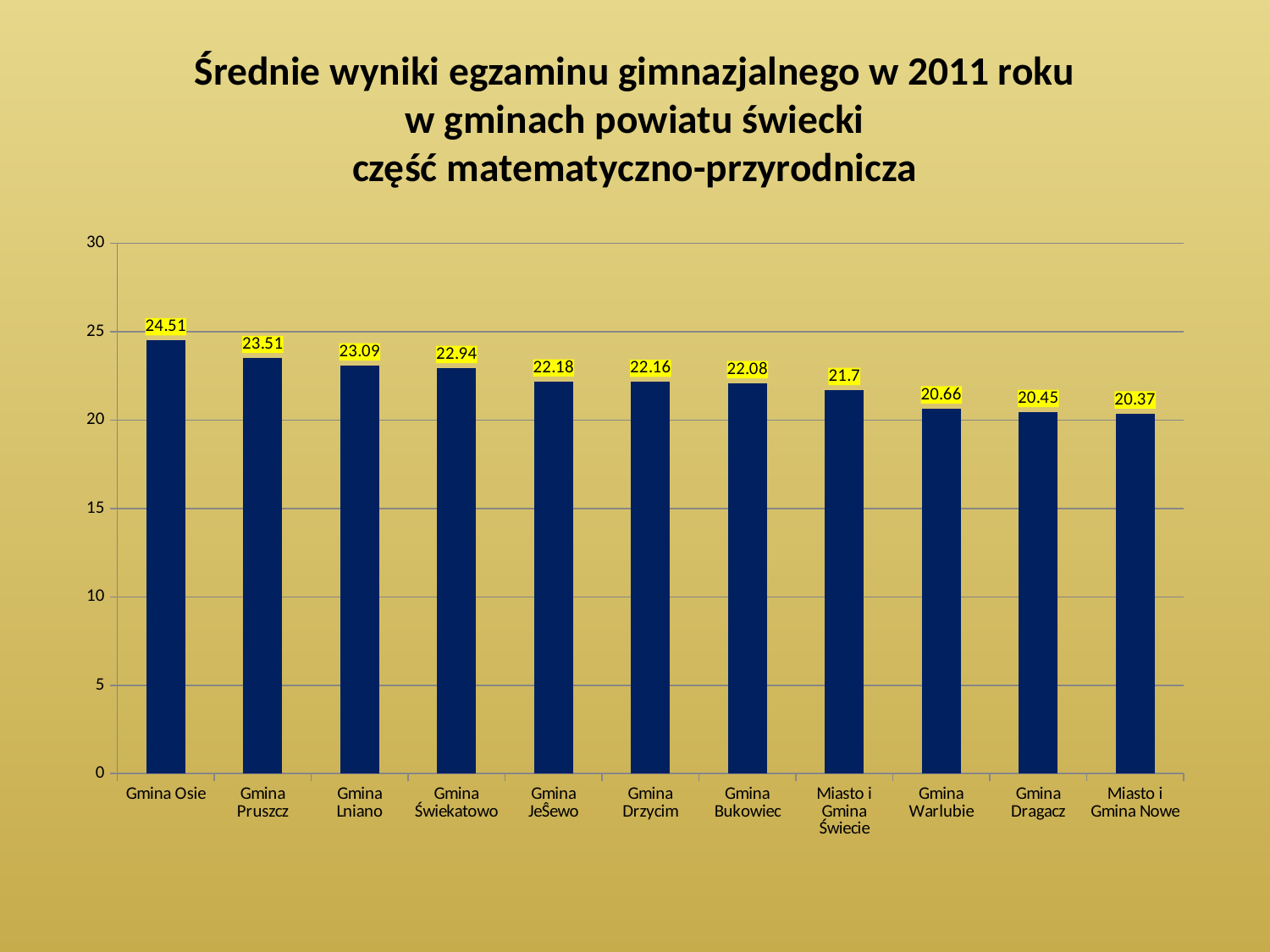
What is the value for Gmina Osie? 24.51 Which category has the lowest value? Miasto i Gmina Nowe Is the value for Gmina Pruszcz greater or less than 25? less What is the difference between the values for Gmina Lniano and Gmina Dragacz? 2.64 What kind of chart is shown on the slide? bar chart What is the value for Miasto i Gmina Świecie? 21.7 How many categories are shown on the x axis? 11 Which is larger, the value for Gmina Świekatowo or the value for Gmina Bukowiec? Gmina Świekatowo Which category has the highest value? Gmina Osie Do the values rise or fall from left to right along the x axis? fall What is the value for Gmina Warlubie? 20.66 What is the difference between the values for Gmina Osie and Gmina Pruszcz? 1